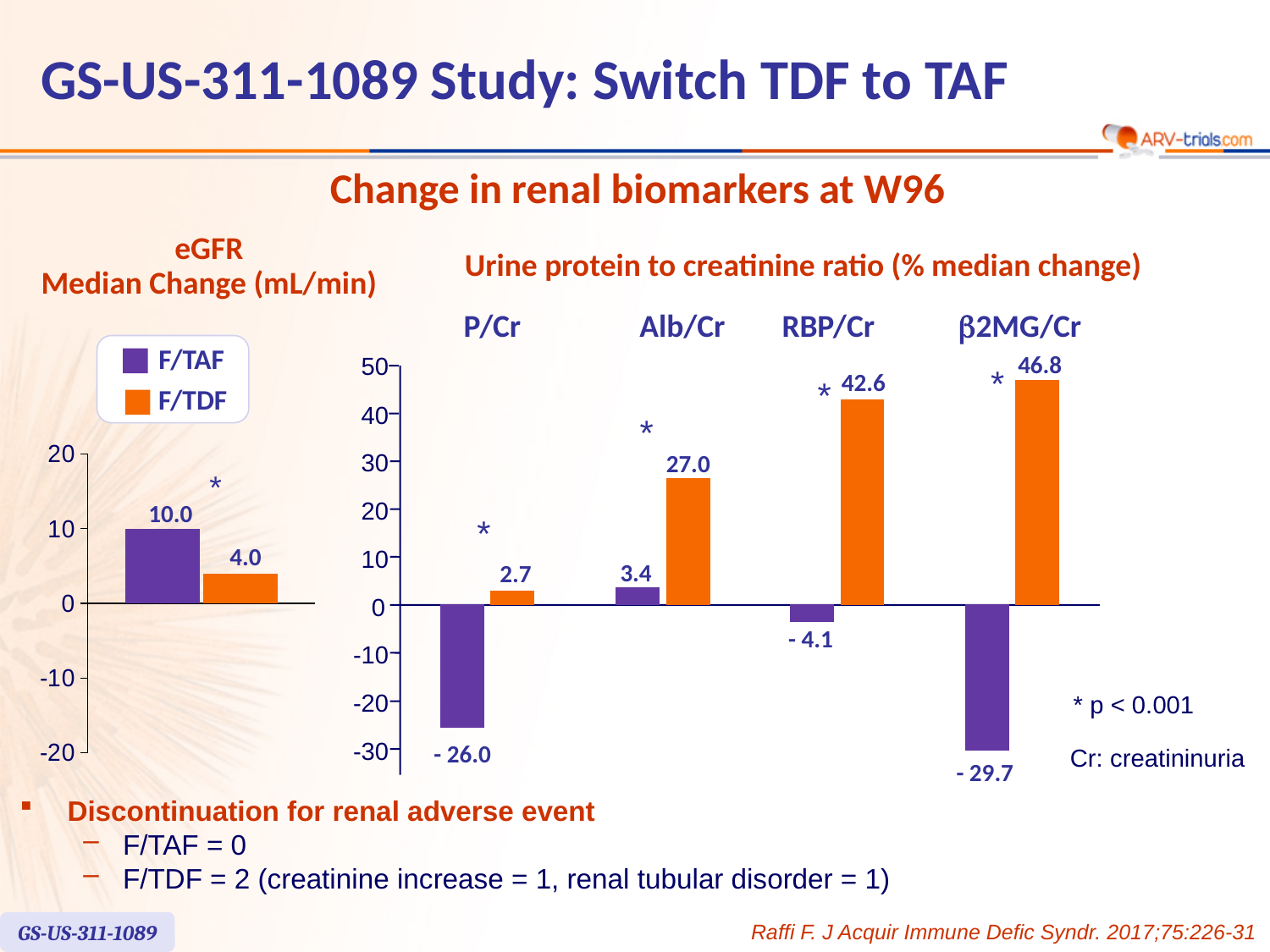
In the Urine protein to creatinine ratio chart, what is the F/TDF value for β2MG/Cr? 46.8 In the Urine protein to creatinine ratio chart, what is the F/TDF value for Alb/Cr? 27.0 In the Urine protein to creatinine ratio chart, which category has the lowest F/TAF value? β2MG/Cr In the Urine protein to creatinine ratio chart, which category has the highest F/TDF value? β2MG/Cr In the Urine protein to creatinine ratio chart, what is the F/TAF value for RBP/Cr? - 4.1 In the eGFR Median Change (mL/min) chart, what is the value for F/TDF? 4.0 How many categories are shown on the x axis of the Urine protein to creatinine ratio chart? 4 In the eGFR Median Change (mL/min) chart, what is the value for F/TAF? 10.0 In the eGFR Median Change (mL/min) chart, what is the difference between the F/TAF and F/TDF values? 6.0 In the Urine protein to creatinine ratio chart, which is larger for Alb/Cr: the F/TAF value or the F/TDF value? F/TDF In the Urine protein to creatinine ratio chart, what is the F/TAF value for P/Cr? - 26.0 How many series does the legend list? 2